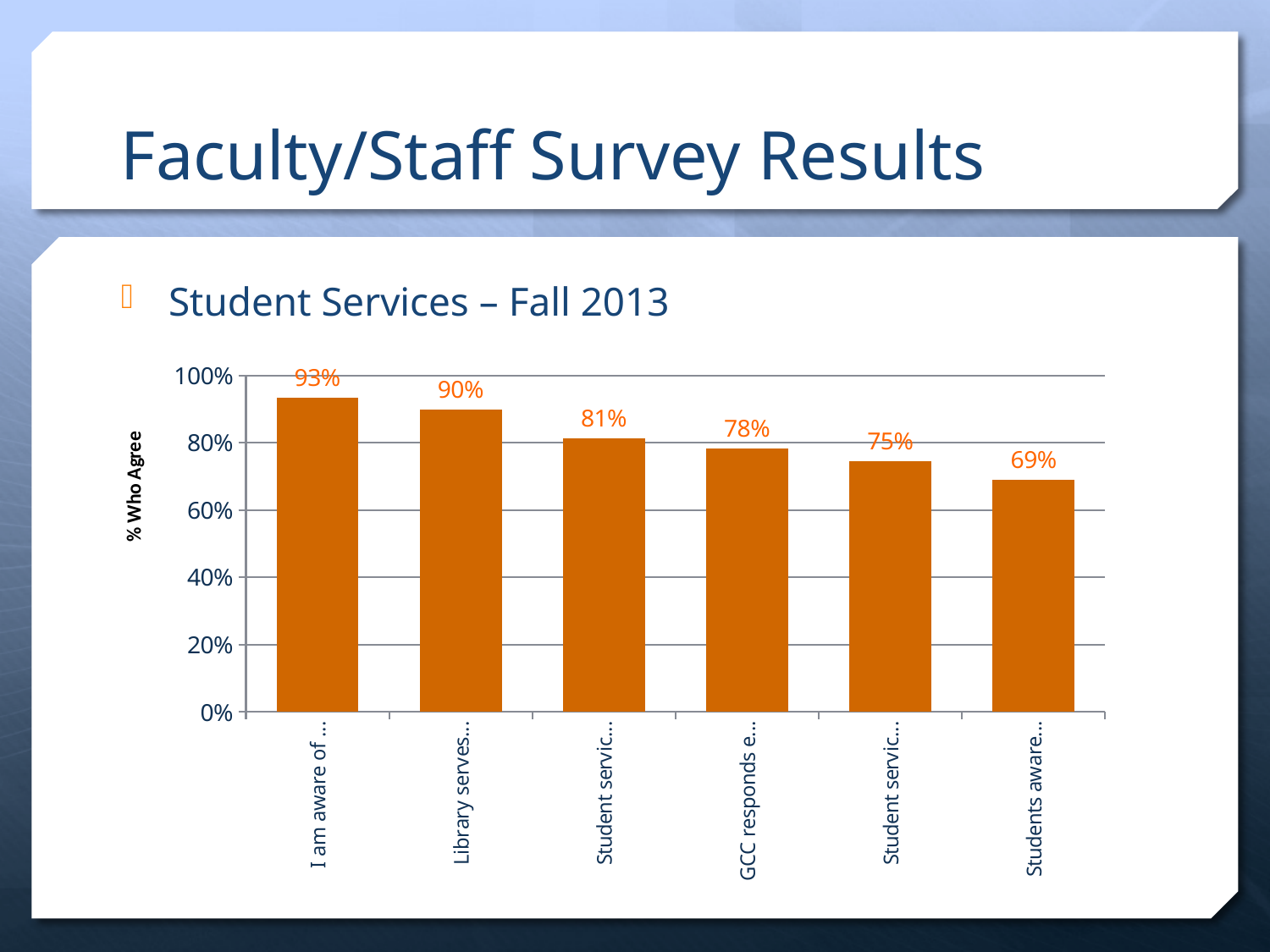
What is the value for the category labelled "Students aware..."? 69% Which category has the lowest value? Students aware... Which is larger, the value for "Library serves..." or the value for "GCC responds e..."? Library serves... Do the bar values rise or fall from left to right across the chart? fall What kind of chart is shown on the slide? bar chart What is the difference between the values for "I am aware of ..." and "Students aware..."? 24% What is the value for the category labelled "I am aware of ..."? 93% How many bars are plotted in the chart? 6 Which category has the highest value? I am aware of ... What is the value for the category labelled "Library serves..."? 90% What is the label on the vertical axis of the chart? % Who Agree What is the value for the category labelled "GCC responds e..."? 78%